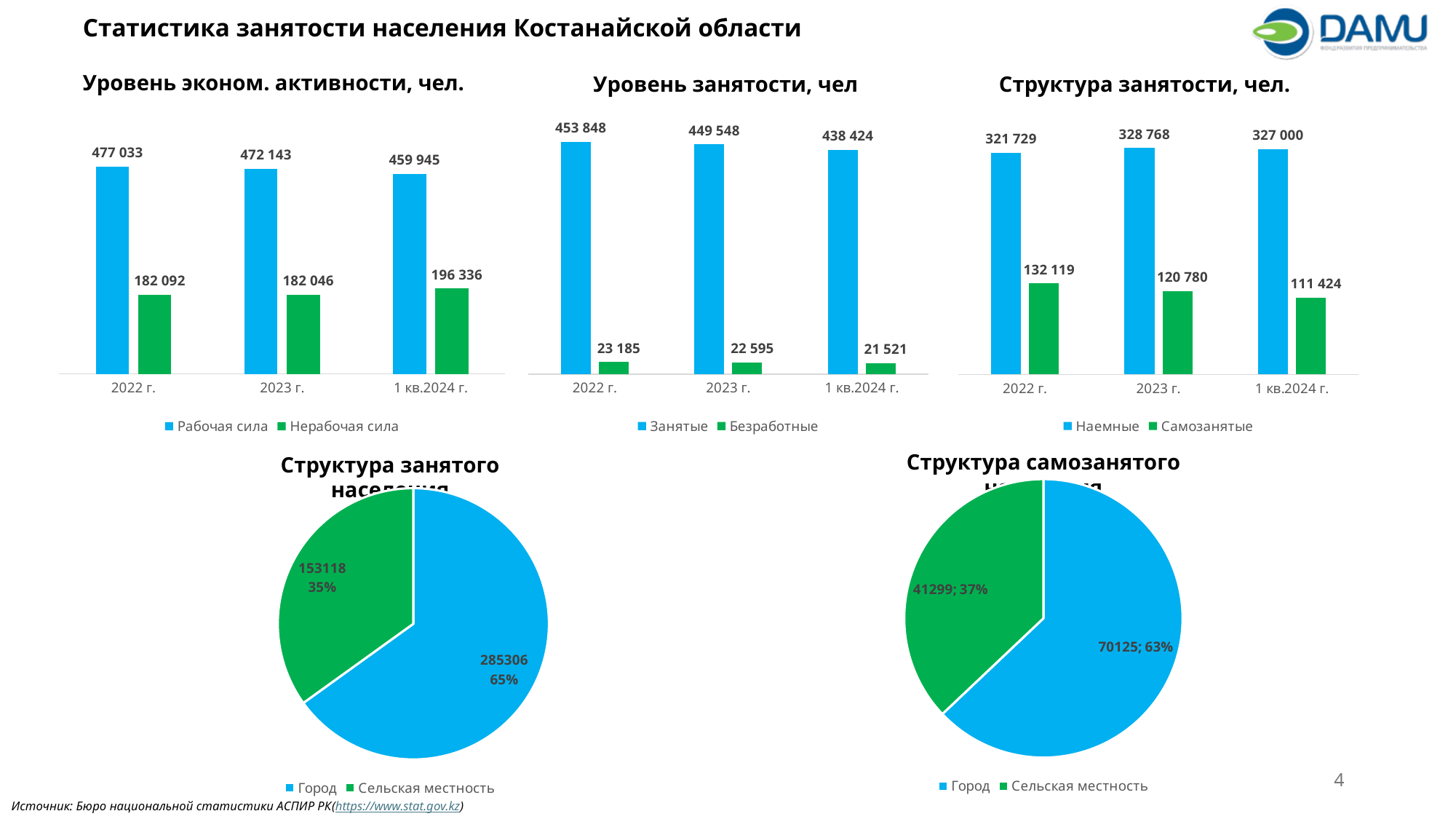
In the chart 'Уровень занятости, чел', does the value of Занятые rise or fall from 2022 г. to 1 кв.2024 г.? fall In the bottom-left pie chart 'Структура занятого населения', what share does Сельская местность have? 35% How many series does the legend of the chart 'Структура занятости, чел.' list? 2 In the chart 'Уровень занятости, чел', what is the difference between Занятые in 2022 г. and 2023 г.? 4 300 In the chart 'Структура занятости, чел.', what is the value of Самозанятые for 1 кв.2024 г.? 111 424 In the chart 'Структура занятости, чел.', which is larger: Наемные in 2023 г. or Наемные in 1 кв.2024 г.? Наемные in 2023 г. In the bottom-right pie chart 'Структура самозанятого населения', what is the value for Город? 70125 In the chart 'Уровень занятости, чел', what is the value of Безработные for 2023 г.? 22 595 In the chart 'Уровень эконом. активности, чел.', which period has the highest value for Нерабочая сила? 1 кв.2024 г. In the chart 'Уровень эконом. активности, чел.', what is the value of Рабочая сила for 2022 г.? 477 033 In the chart 'Структура занятости, чел.', which period has the lowest value for Самозанятые? 1 кв.2024 г. What kind of chart is the bottom-right chart 'Структура самозанятого населения'? pie chart